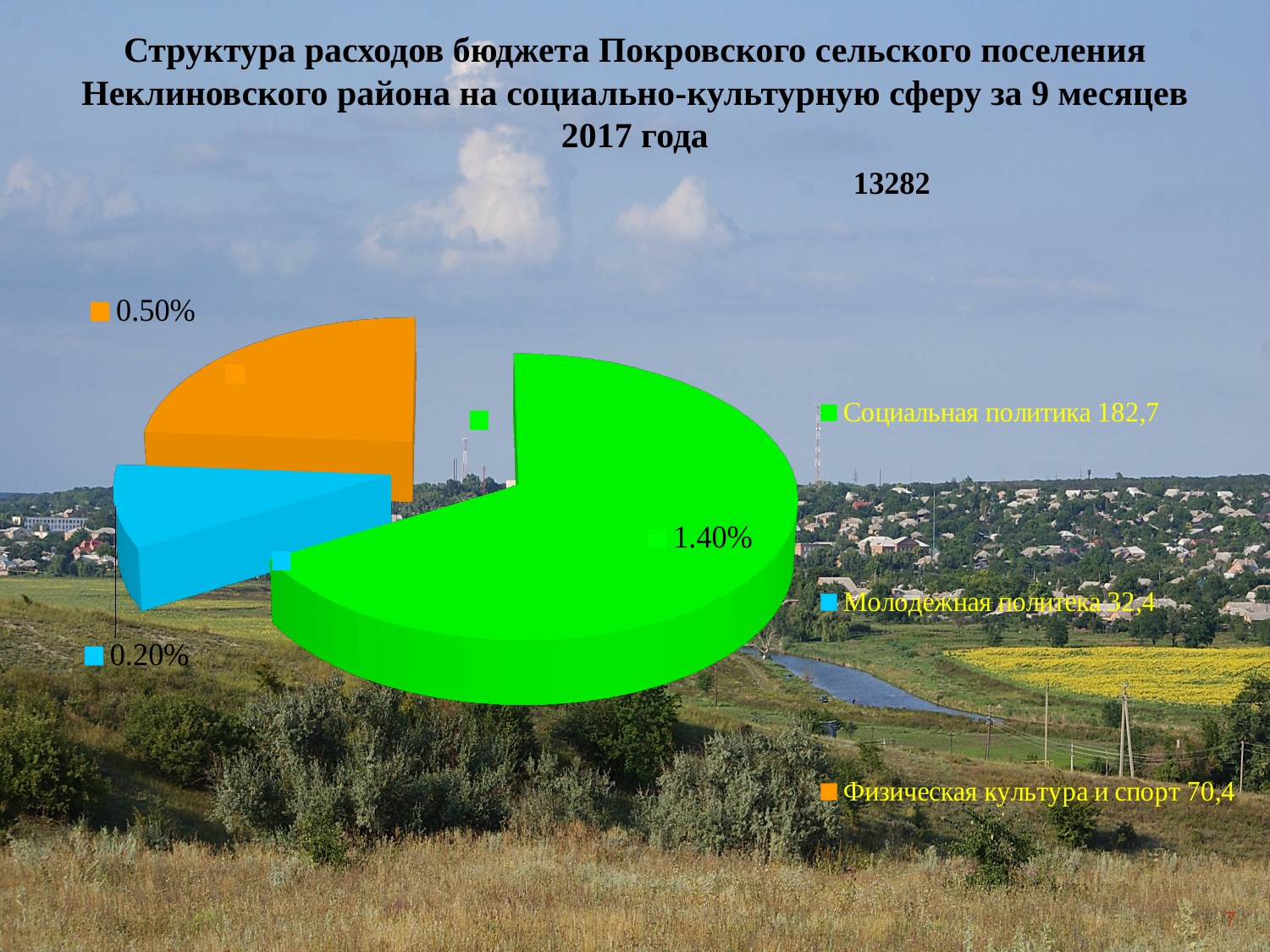
What kind of chart is shown on the slide? pie chart What value is shown for Физическая культура и спорт? 70,4 How many slices does the pie chart have? 3 Which category has the largest slice of the pie? Социальная политика What value is shown for Молодежная политика? 32,4 What is the difference between the values for Социальная политика and Физическая культура и спорт? 112,3 What percentage label is printed on the green slice? 1.40% What number is printed below the chart title? 13282 What colour is the slice for Социальная политика? green Which category has the smallest slice of the pie? Молодежная политика Which is larger, Физическая культура и спорт or Молодежная политика? Физическая культура и спорт What value is shown for Социальная политика? 182,7